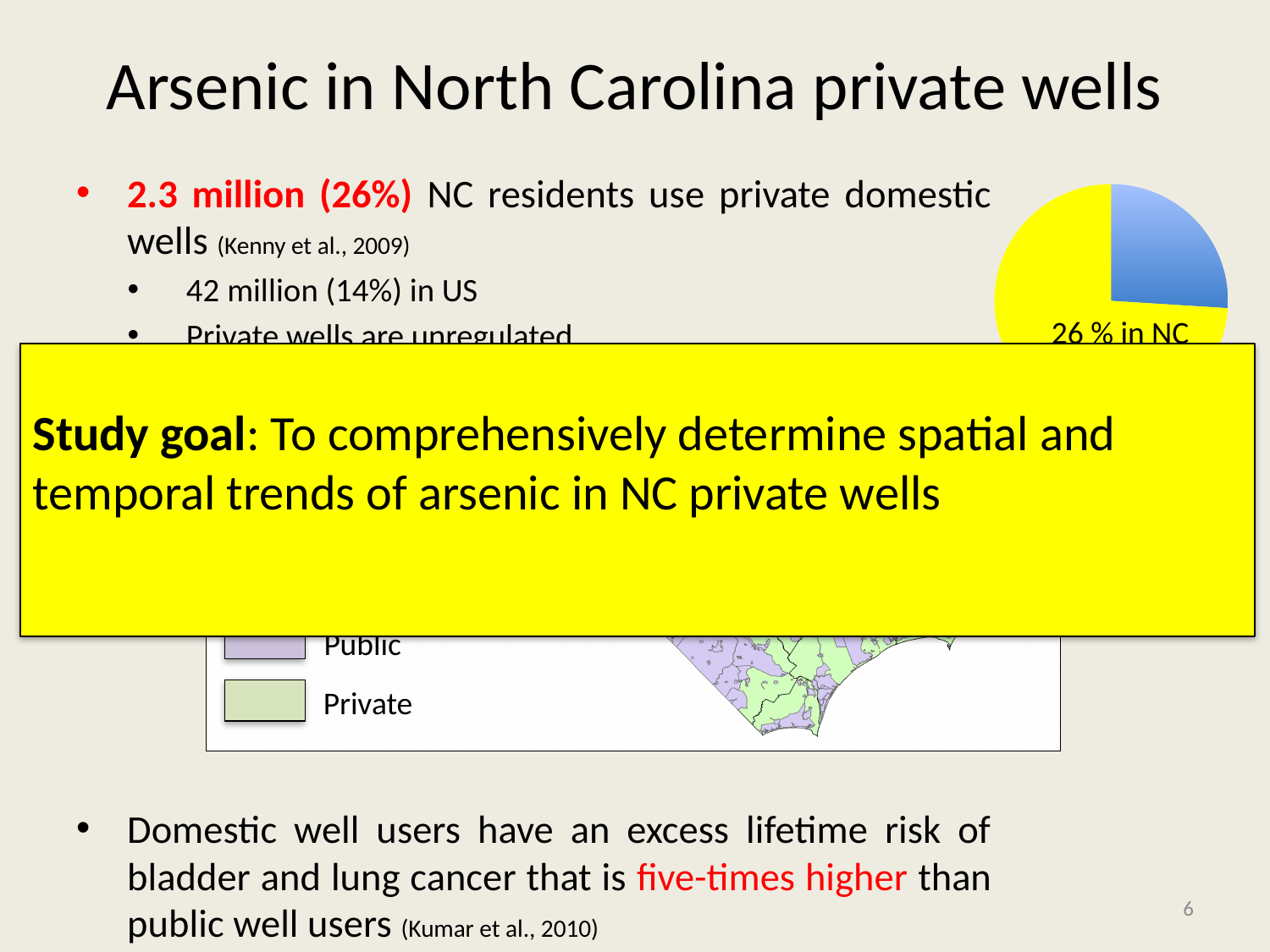
In the pie chart, what share is labelled for the blue slice? 26 % in NC What kind of chart is shown in the top right of the slide? pie chart In the pie chart, which slice is larger, the blue slice or the yellow slice? yellow Which slice of the pie chart is the smallest? the blue slice (26 % in NC) In the pie chart, is the blue slice greater or less than half of the pie? less How many slices does the pie chart have? 2 What colour is the slice labelled "26 % in NC" in the pie chart? blue